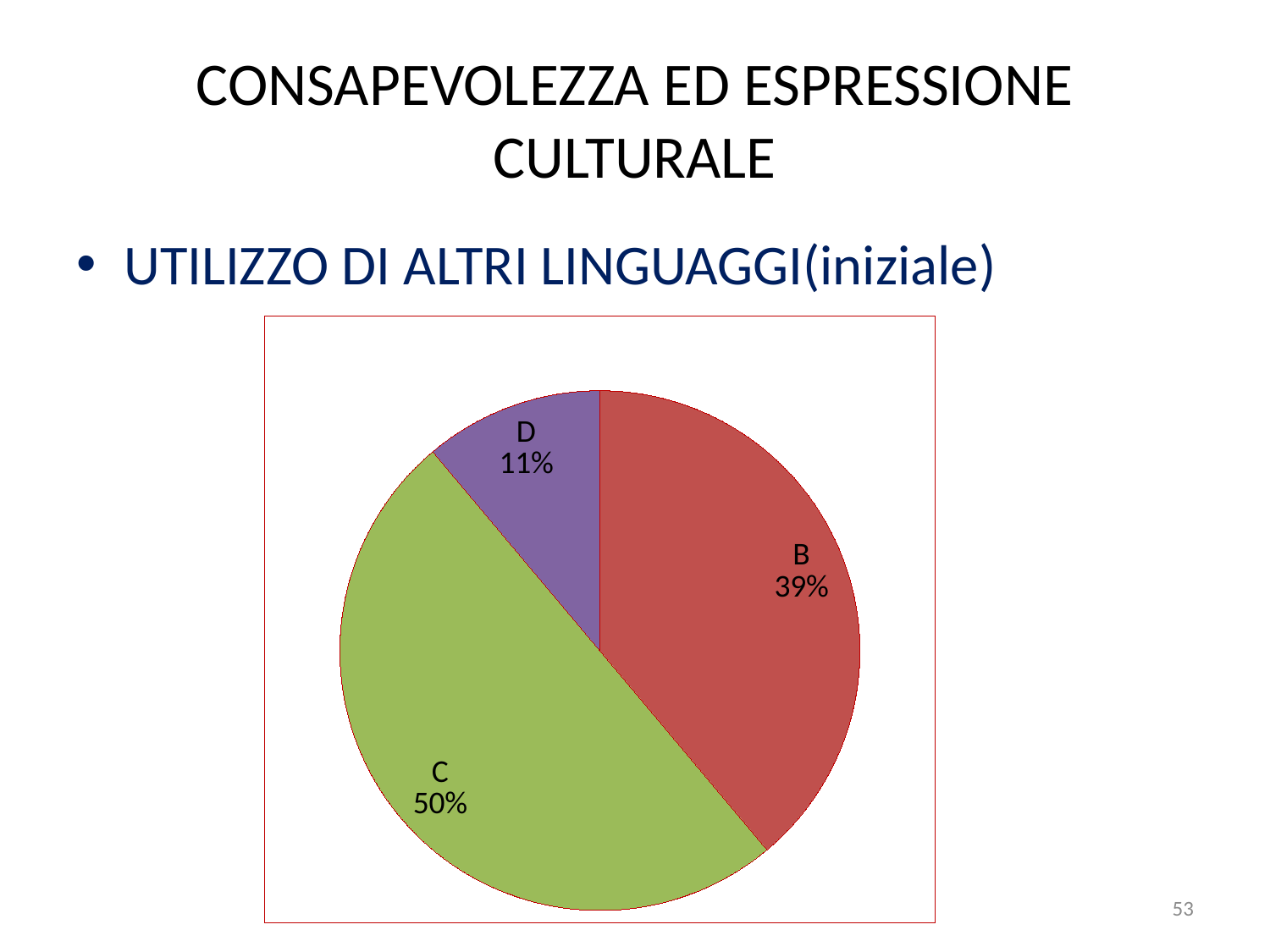
What share of the pie does slice C represent? 50% What share of the pie does slice B represent? 39% What is the bullet text above the chart? UTILIZZO DI ALTRI LINGUAGGI(iniziale) What share of the pie does slice D represent? 11% Which slice is the largest in the pie chart? C What kind of chart is shown on the slide? pie chart Which slice is the smallest in the pie chart? D What is the difference in percentage points between slice B and slice D? 28% Which is larger, slice B or slice D? B What is the difference in percentage points between slice C and slice B? 11% How many slices does the pie chart have? 3 What colour is slice C in the pie chart? green